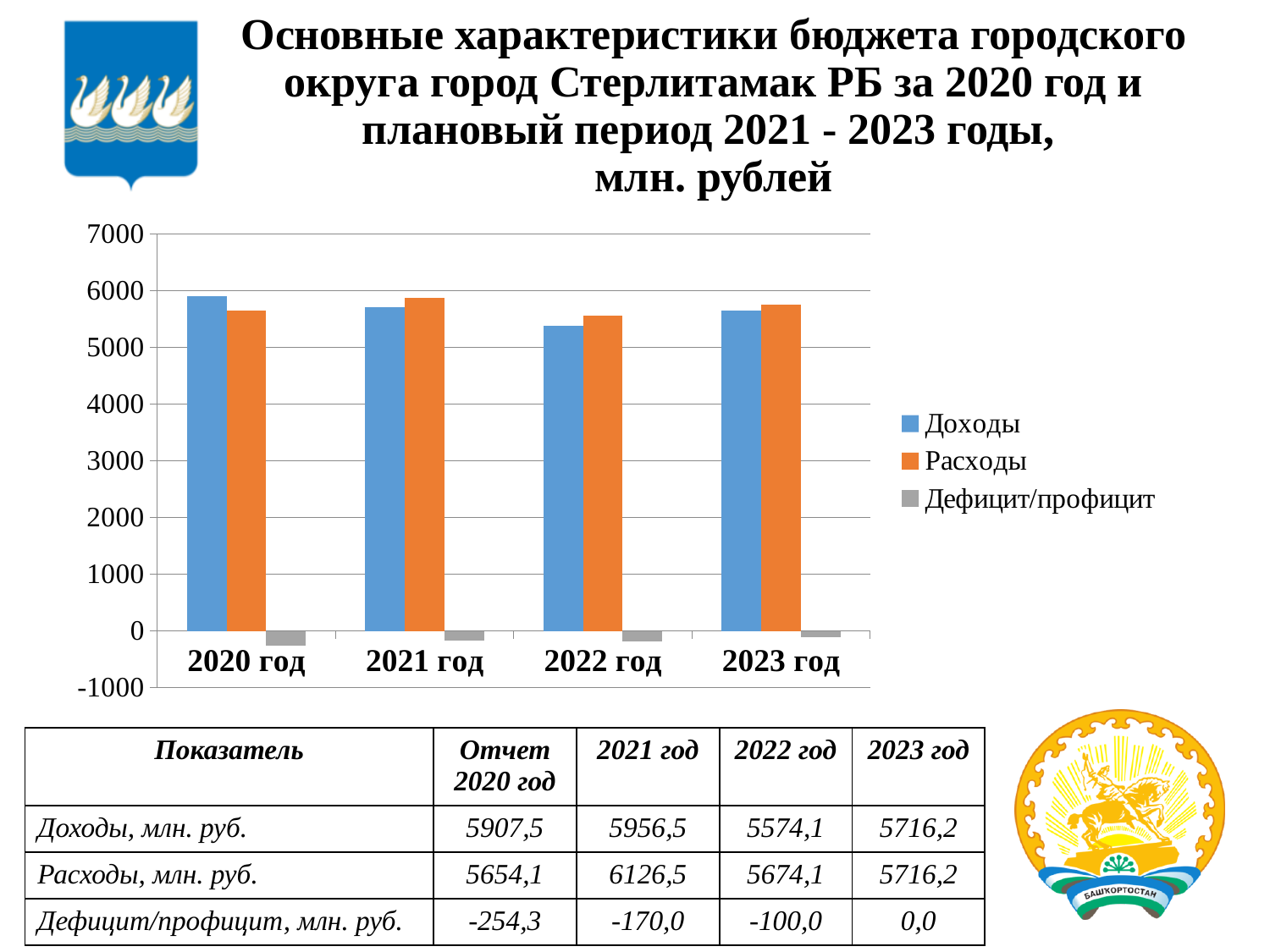
In the chart, is the Дефицит/профицит value for 2020 год greater or less than 0? less In the chart, which is larger for 2021 год: Доходы or Расходы? Расходы In the chart, which year has the lowest Доходы bar? 2022 год In the chart, which is larger for 2020 год: Доходы or Расходы? Доходы In the chart, which year has the highest Доходы bar? 2020 год How many year categories are shown on the x axis of the chart? 4 In the chart, is the Доходы value for 2020 год greater or less than 5000? greater Which series is shown in grey in the chart? Дефицит/профицит How many series does the chart legend list? 3 What kind of chart is shown on the slide? bar chart In the chart, is the Расходы value for 2021 год greater or less than 6000? less Which series is shown in orange in the chart? Расходы